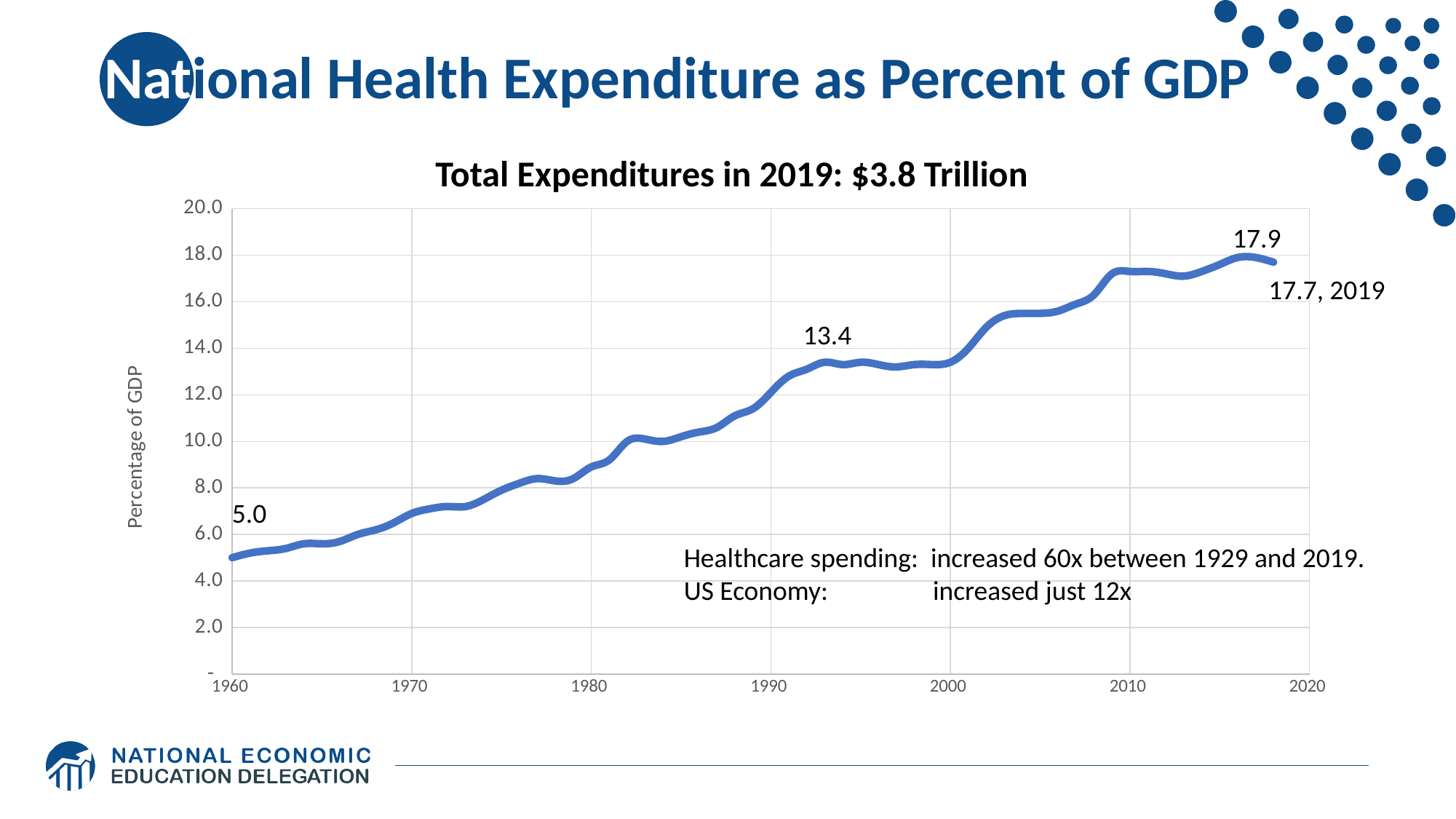
What is the highest value labeled on the line? 17.9 What is the national health expenditure as a percent of GDP in 2019? 17.7 Is the value for 1970 greater or less than 8.0? less Which is larger, the labeled value 13.4 or the labeled value 17.9? 17.9 What is the chart's title? Total Expenditures in 2019: $3.8 Trillion What kind of chart is shown on the slide? line chart What is the difference between the 2019 value (17.7) and the 1960 value (5.0)? 12.7 What is the value labeled at the start of the line in 1960? 5.0 Is the value for 1990 greater or less than 10.0? greater Overall, does the line rise or fall from 1960 to 2019? rise What is the lowest value labeled on the line? 5.0 What is the label on the vertical axis? Percentage of GDP